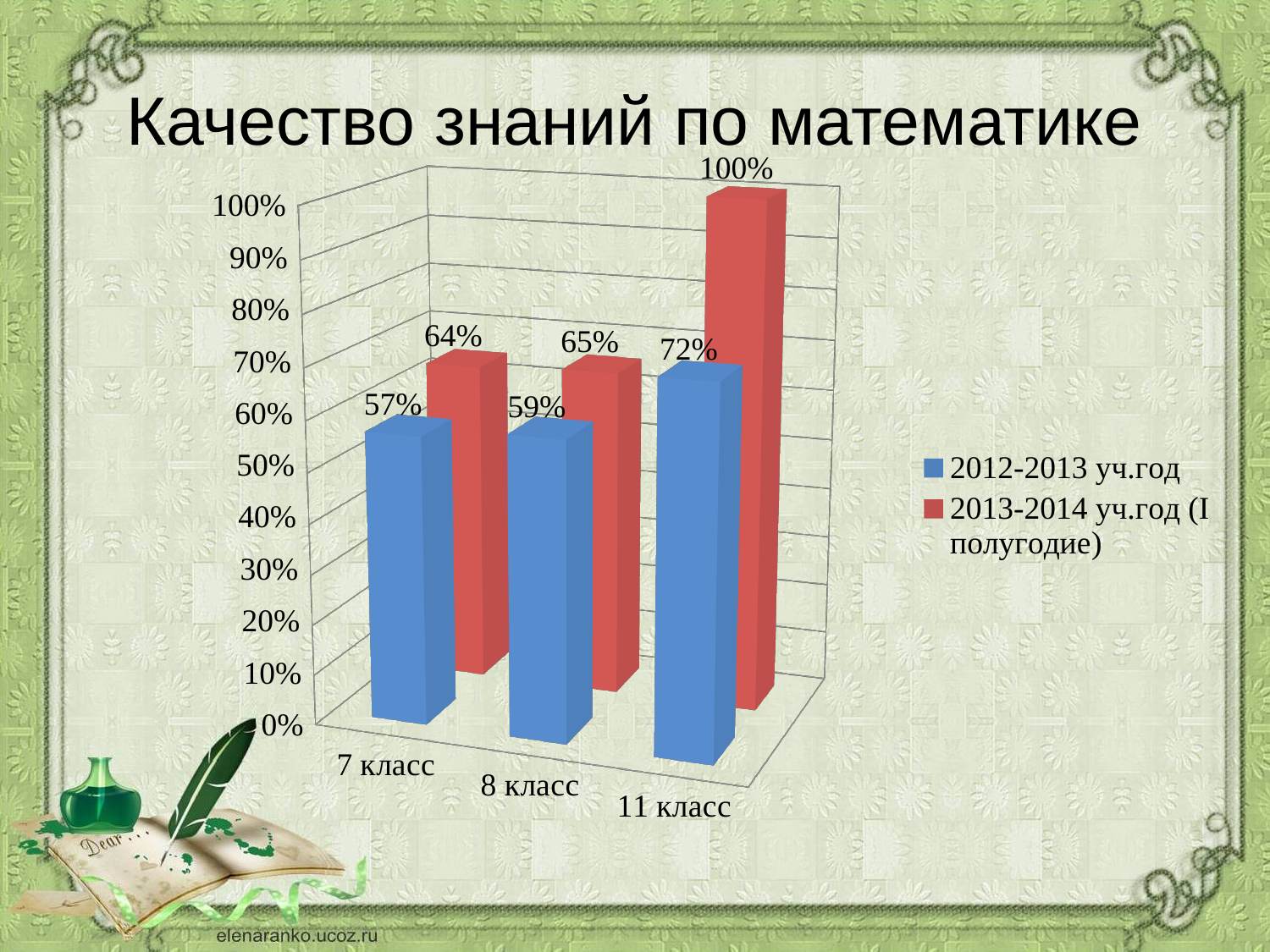
What is the value for 8 класс in the 2013-2014 уч.год (I полугодие) series? 65% How many classes are shown on the x axis? 3 Which class has the lowest value in the 2013-2014 уч.год (I полугодие) series? 7 класс What kind of chart is shown on the slide? Bar chart Do the values in the 2012-2013 уч.год series rise or fall from 7 класс to 11 класс? Rise How many series does the legend list? 2 What is the value for 7 класс in the 2012-2013 уч.год series? 57% What is the difference between the 2013-2014 уч.год (I полугодие) and 2012-2013 уч.год values for 11 класс? 28% What is the title of the chart? Качество знаний по математике Which class has the highest value in the 2012-2013 уч.год series? 11 класс Which is larger for 8 класс: the 2012-2013 уч.год value or the 2013-2014 уч.год (I полугодие) value? 2013-2014 уч.год (I полугодие) What is the value for 11 класс in the 2013-2014 уч.год (I полугодие) series? 100%